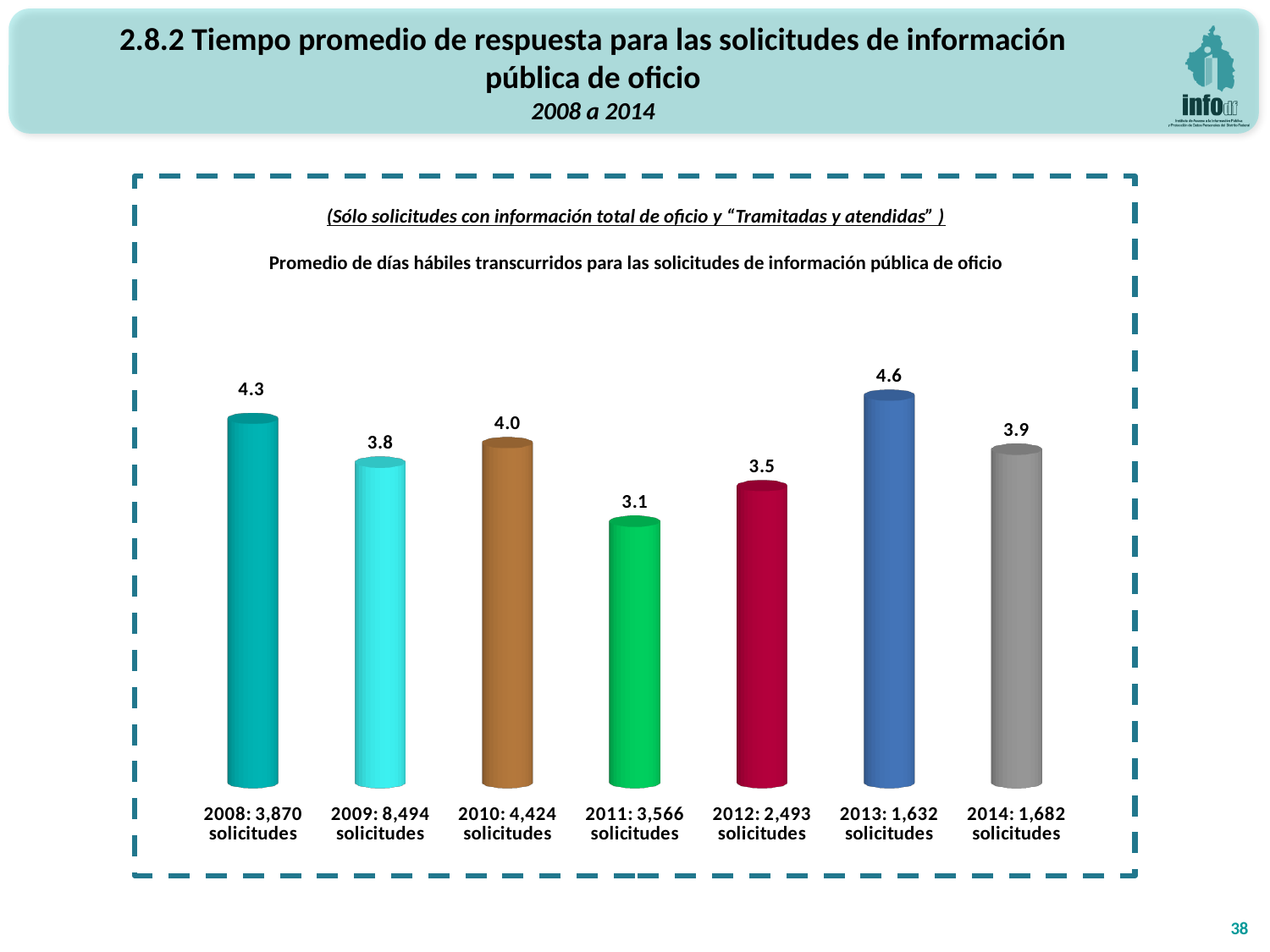
How many years (bars) are shown in the chart? 7 Do the values rise or fall from 2010 to 2011? fall What is the value shown for 2014? 3.9 Which is larger, the value for 2010 or the value for 2012? 2010 What kind of chart is shown on the slide? bar chart What is the value shown for 2011? 3.1 What is the value shown for 2013? 4.6 Which year has the lowest average number of business days? 2011 How many solicitudes are indicated in the label for 2009? 8,494 What is the difference between the values for 2013 and 2011? 1.5 Which year has the highest average number of business days? 2013 What is the average number of business days for 2008? 4.3